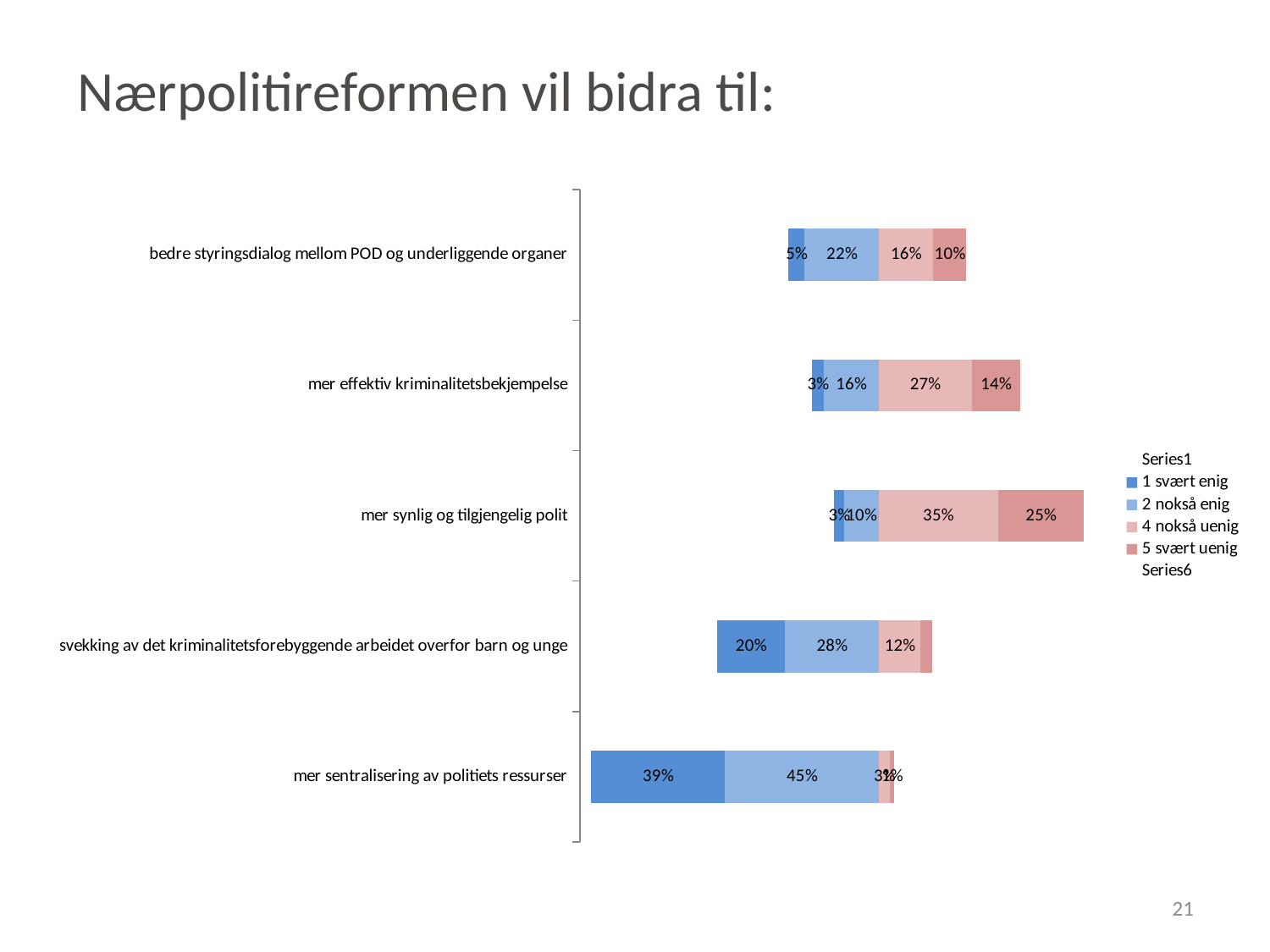
Which category has the highest '1 svært enig' value? mer sentralisering av politiets ressurser How many entries does the legend list? 6 What is the '5 svært uenig' value for 'mer effektiv kriminalitetsbekjempelse'? 14% Which is larger: the '1 svært enig' value for 'svekking av det kriminalitetsforebyggende arbeidet overfor barn og unge' or for 'bedre styringsdialog mellom POD og underliggende organer'? svekking av det kriminalitetsforebyggende arbeidet overfor barn og unge What is the '2 nokså enig' value for 'bedre styringsdialog mellom POD og underliggende organer'? 22% Which category has the highest '5 svært uenig' value? mer synlig og tilgjengelig polit What kind of chart is shown on the slide? Stacked bar chart How many categories are plotted on the chart? 5 What is the '1 svært enig' value for 'mer sentralisering av politiets ressurser'? 39% What is the difference between the '4 nokså uenig' values for 'mer synlig og tilgjengelig polit' and 'mer effektiv kriminalitetsbekjempelse'? 8% What is the '2 nokså enig' value for 'mer sentralisering av politiets ressurser'? 45% What is the '4 nokså uenig' value for 'mer synlig og tilgjengelig polit'? 35%